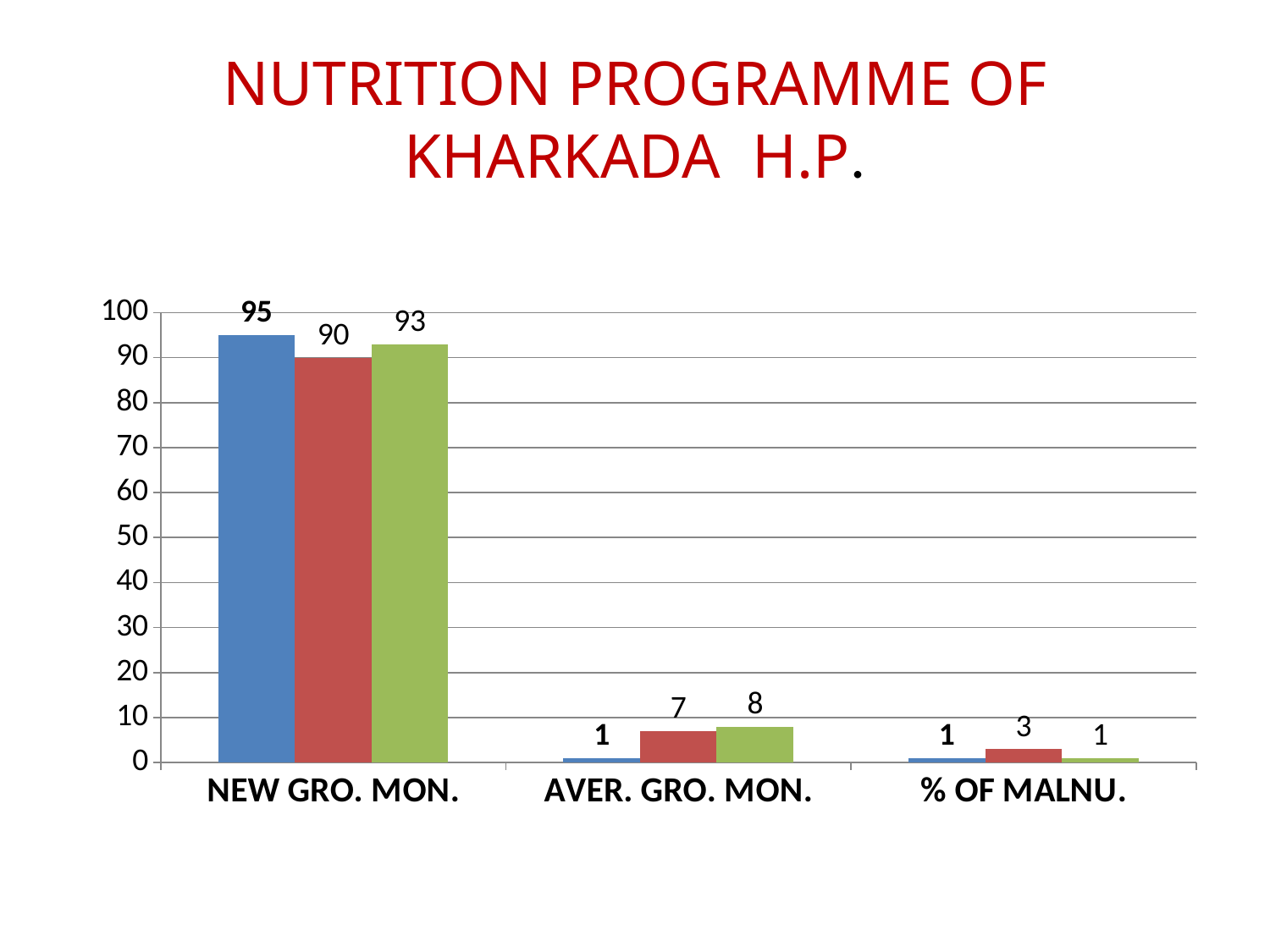
What is the value of the blue bar for NEW GRO. MON.? 95 Which category has the lowest red bar? % OF MALNU. What is the value of the red bar for AVER. GRO. MON.? 7 What is the difference between the green bar and the blue bar for AVER. GRO. MON.? 7 What is the difference between the blue bar and the red bar for NEW GRO. MON.? 5 What is the value of the green bar for % OF MALNU.? 1 Which is larger for NEW GRO. MON., the green bar or the red bar? green bar What kind of chart is shown on the slide? bar chart How many categories are shown on the x axis? 3 Which category has the highest green bar? NEW GRO. MON. What is the title of the slide containing the chart? NUTRITION PROGRAMME OF KHARKADA H.P. What is the value of the red bar for % OF MALNU.? 3